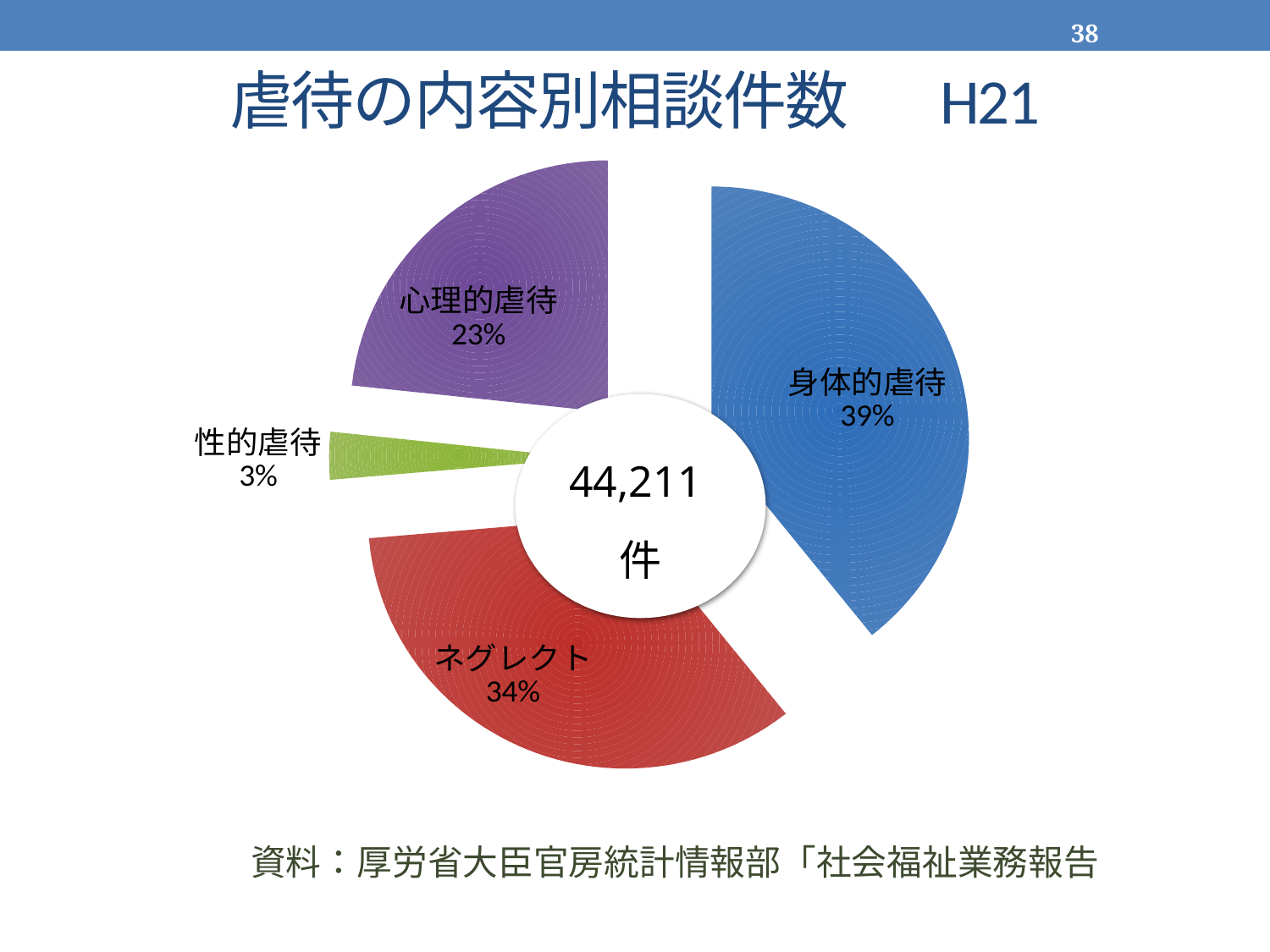
Which category has the smallest slice of the pie? 性的虐待 What share of the pie does 性的虐待 represent? 3% What share of the pie does 身体的虐待 represent? 39% What share of the pie does 心理的虐待 represent? 23% What is the difference in percentage points between 心理的虐待 and 性的虐待? 20 Which is larger, the share for ネグレクト or the share for 心理的虐待? ネグレクト What is the difference in percentage points between 身体的虐待 and ネグレクト? 5 What total number of cases is shown in the centre of the pie chart? 44,211件 What kind of chart is shown on the slide? pie chart Which category has the largest slice of the pie? 身体的虐待 How many categories are shown in the pie chart? 4